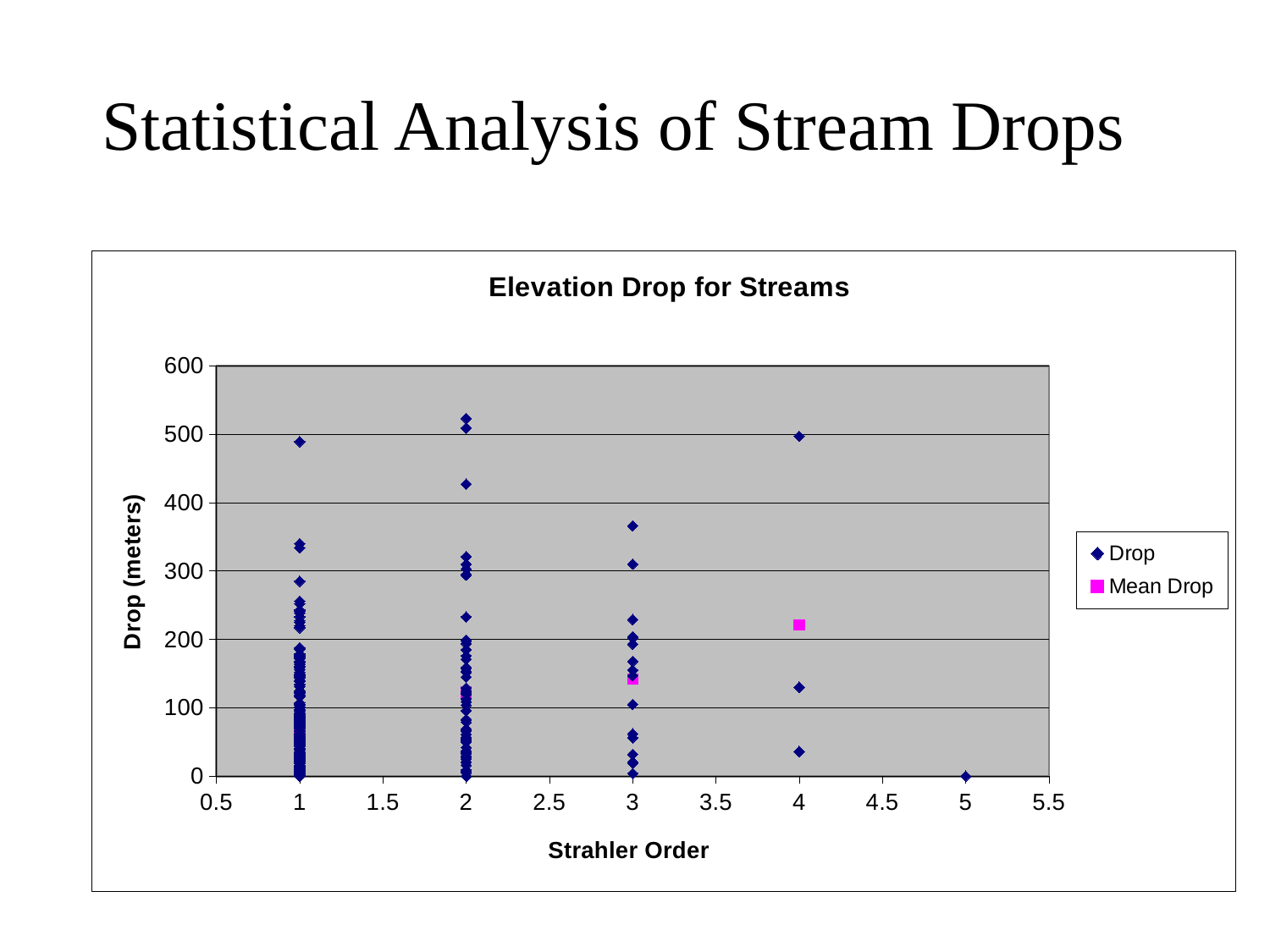
Is the highest Drop value at Strahler Order 2 greater or less than 500? greater Which Strahler Order has the highest Drop value plotted on the chart? 2 Is the Mean Drop value at Strahler Order 4 greater or less than 200? greater Is the Mean Drop value at Strahler Order 3 greater or less than 100? greater What is the label of the y axis of the chart? Drop (meters) What is the title of the chart? Elevation Drop for Streams How many series does the legend of the chart list? 2 What kind of chart is shown on the slide? Scatter chart How many distinct Strahler Order values have Drop points plotted on the chart? 5